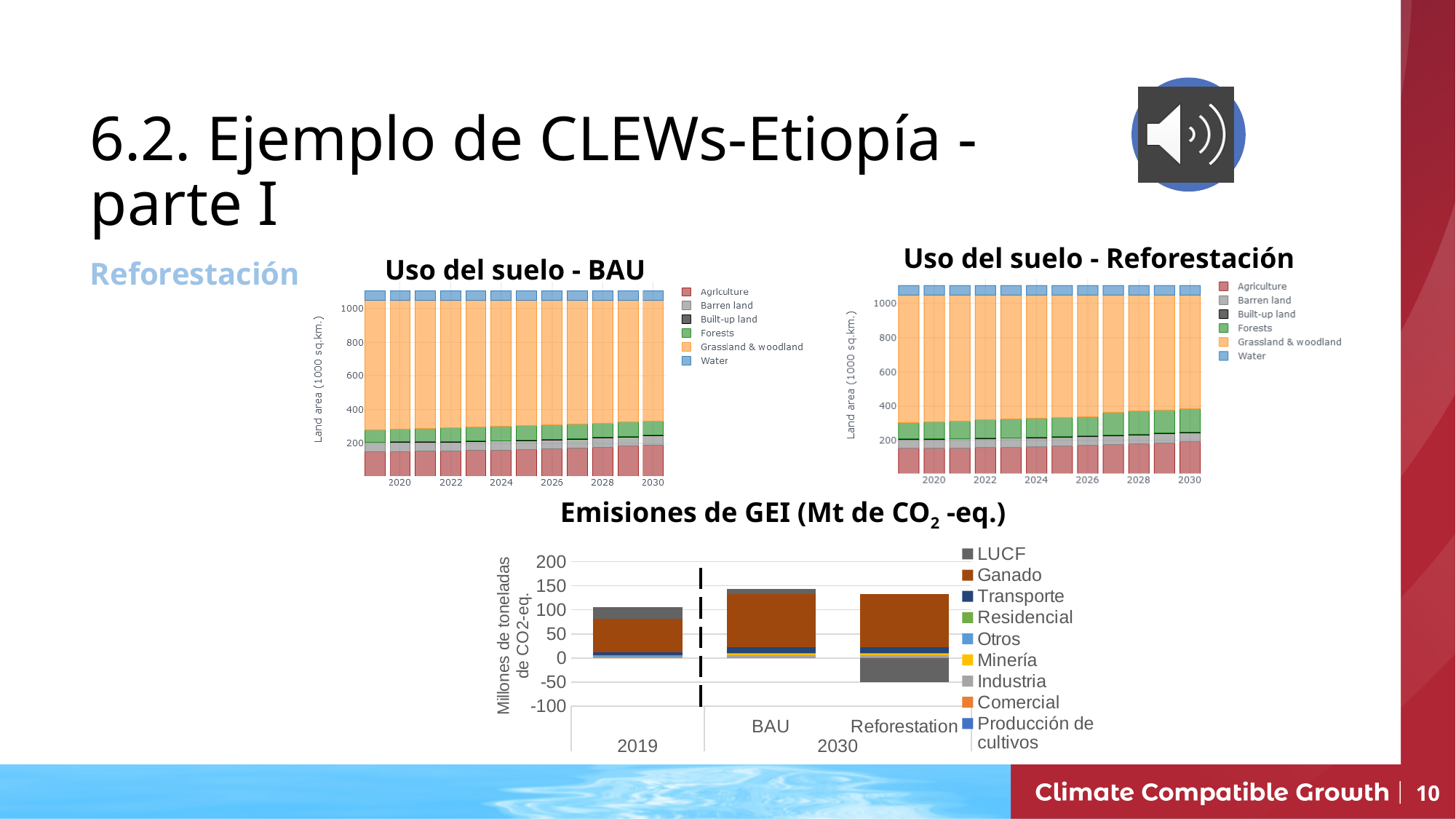
How many series does the legend of the 'Emisiones de GEI (Mt de CO2 -eq.)' chart list? 9 In the 'Uso del suelo - Reforestación' chart, does the Forests area rise or fall from 2020 to 2030? rise How many series does the legend of the 'Uso del suelo - BAU' chart list? 6 In the 'Emisiones de GEI (Mt de CO2 -eq.)' chart, is the top of the BAU 2030 bar greater or less than 150? less In the 'Emisiones de GEI (Mt de CO2 -eq.)' chart, which series forms the largest segment of each bar? Ganado What is the y-axis label of the 'Uso del suelo - BAU' chart? Land area (1000 sq.km.) In the 'Emisiones de GEI (Mt de CO2 -eq.)' chart, which 2030 scenario bar has a negative LUCF segment? Reforestation What kind of chart is the 'Emisiones de GEI (Mt de CO2 -eq.)' chart? stacked bar chart In the 'Emisiones de GEI (Mt de CO2 -eq.)' chart, is the top of the Reforestation 2030 bar greater or less than 100? greater In the 'Uso del suelo - Reforestación' chart, which land use category occupies the largest area? Grassland & woodland How many bars are plotted in the 'Emisiones de GEI (Mt de CO2 -eq.)' chart? 3 What is the y-axis label of the 'Emisiones de GEI (Mt de CO2 -eq.)' chart? Millones de toneladas de CO2-eq.